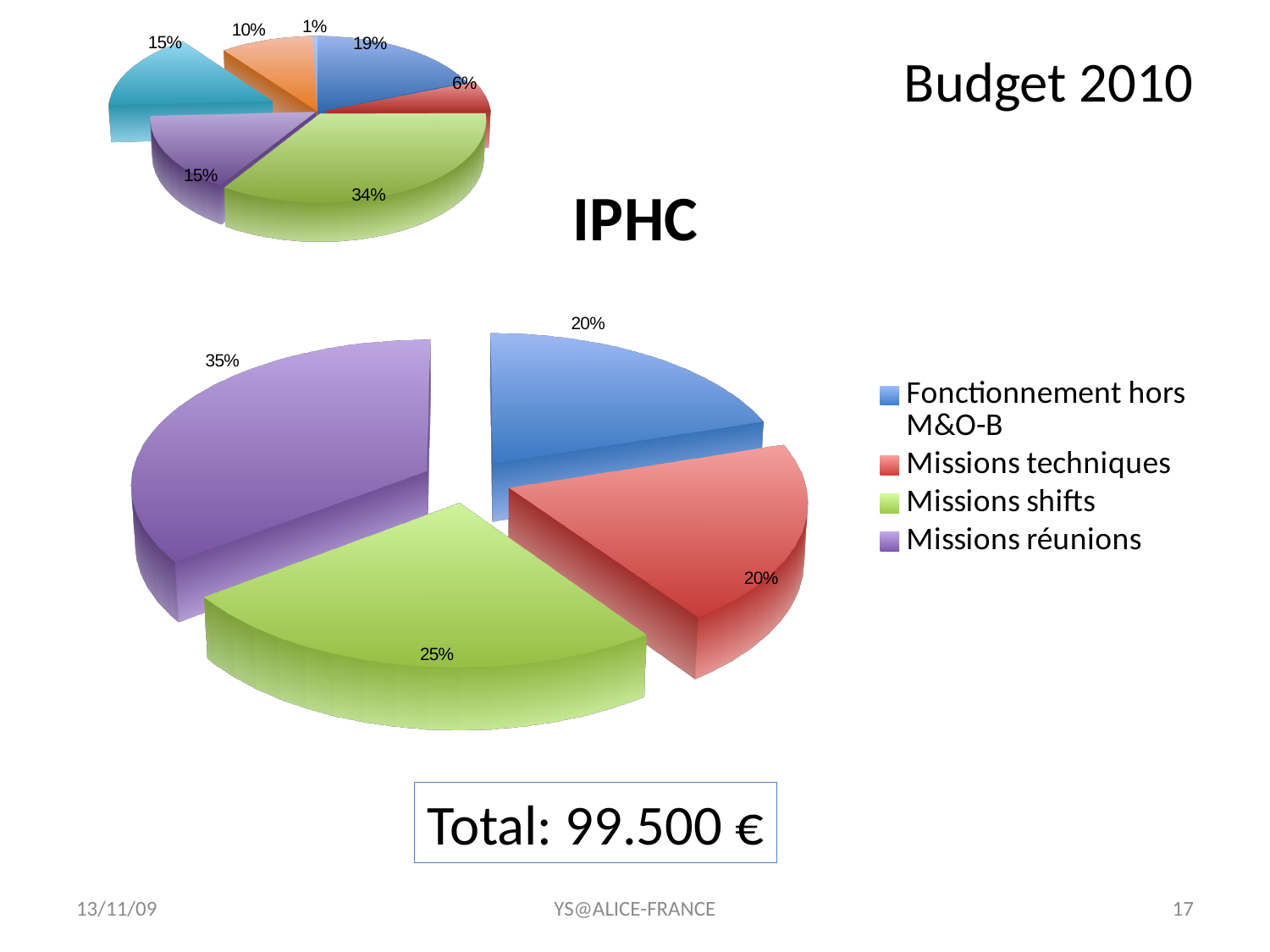
In the IPHC pie chart, which is larger: Missions shifts or Missions techniques? Missions shifts In the IPHC pie chart, what share does Fonctionnement hors M&O-B have? 20% What kind of chart is the IPHC chart? Pie chart In the IPHC pie chart, what is the difference between the shares of Missions réunions and Missions shifts? 10% In the small pie chart in the top-left corner, what is the percentage of the largest slice? 34% In the IPHC pie chart, what share does Missions réunions have? 35% In the IPHC pie chart, what share does Missions shifts have? 25% In the small pie chart in the top-left corner, what is the percentage of the smallest slice? 1% How many slices does the small pie chart in the top-left corner of the slide have? 7 How many categories does the legend of the IPHC pie chart list? 4 In the IPHC pie chart, which category has the largest slice? Missions réunions In the IPHC pie chart, what share does Missions techniques have? 20%